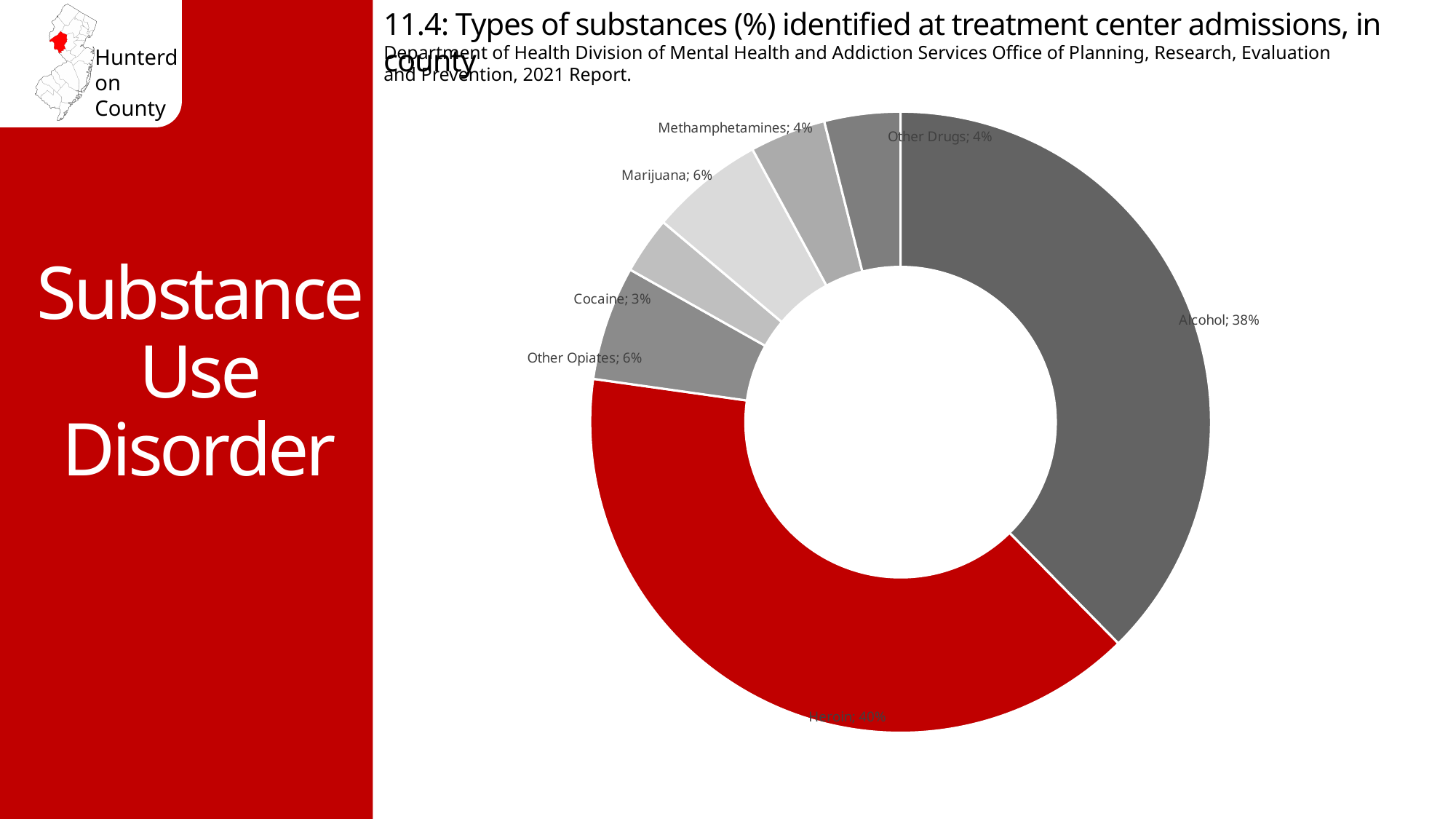
What percentage is shown for Methamphetamines? 4% What percentage of treatment center admissions is identified as Alcohol? 38% Which is larger, the share for Alcohol or the share for Other Drugs? Alcohol What percentage is shown for Heroin? 40% What percentage is shown for Cocaine? 3% What kind of chart is shown on the slide? Pie chart (doughnut) What percentage is shown for Other Opiates? 6% What percentage is shown for Marijuana? 6% What is the difference in percentage points between Alcohol and Marijuana? 32 percentage points Which substance has the largest share of admissions? Heroin Which substance has the smallest share of admissions? Cocaine How many substance categories are shown in the chart? 7